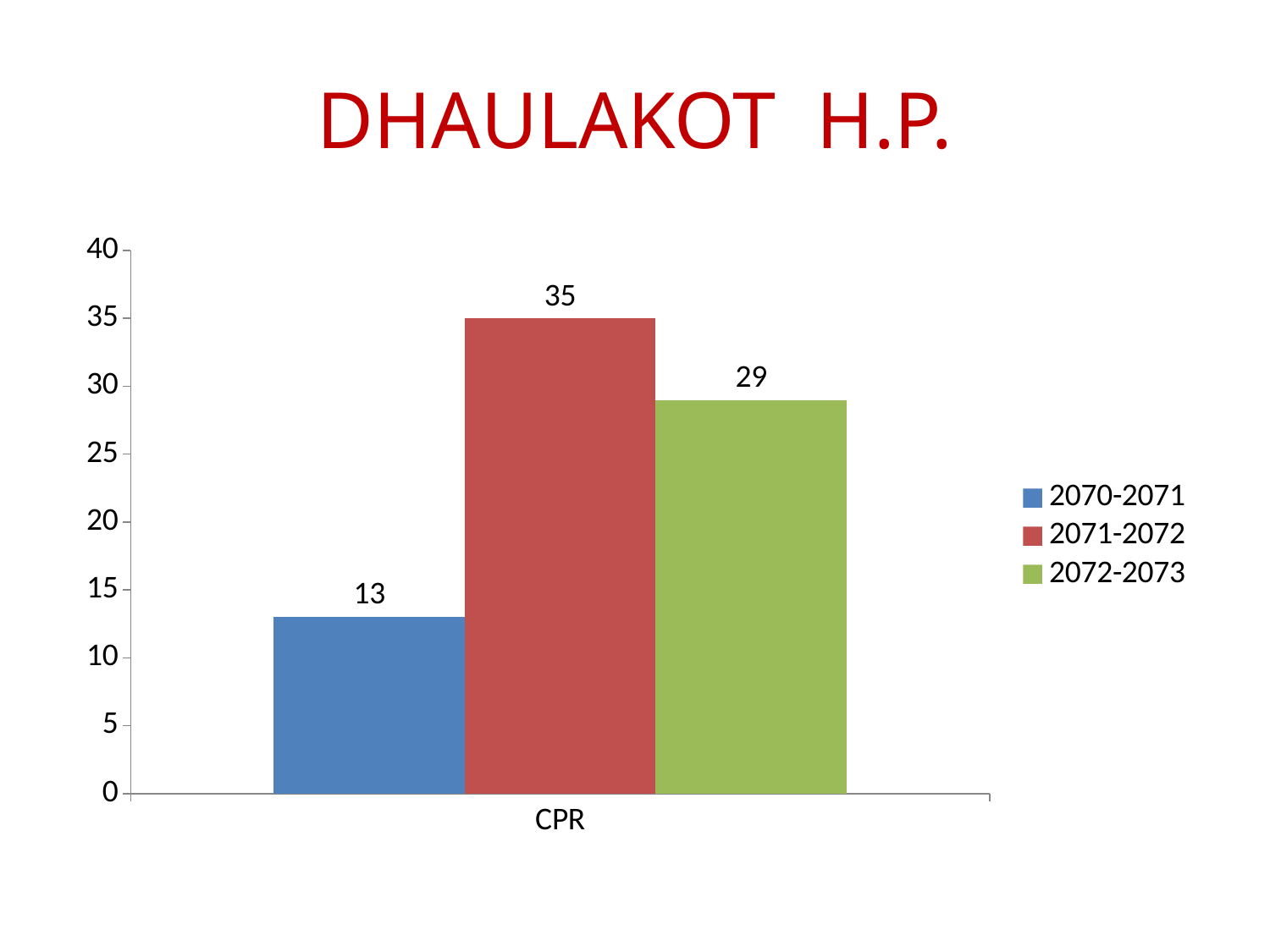
How many series does the legend list? 3 Is the CPR value for 2072-2073 greater or less than 25? greater What is the CPR value for 2072-2073? 29 What is the title of the slide? DHAULAKOT H.P. What is the CPR value for 2071-2072? 35 Which is larger, the CPR value for 2072-2073 or for 2070-2071? 2072-2073 What is the difference between the CPR values for 2071-2072 and 2072-2073? 6 What is the difference between the CPR values for 2071-2072 and 2070-2071? 22 Which series has the lowest CPR value? 2070-2071 What kind of chart is shown on the slide? Bar chart Which series has the highest CPR value? 2071-2072 What is the CPR value for 2070-2071? 13